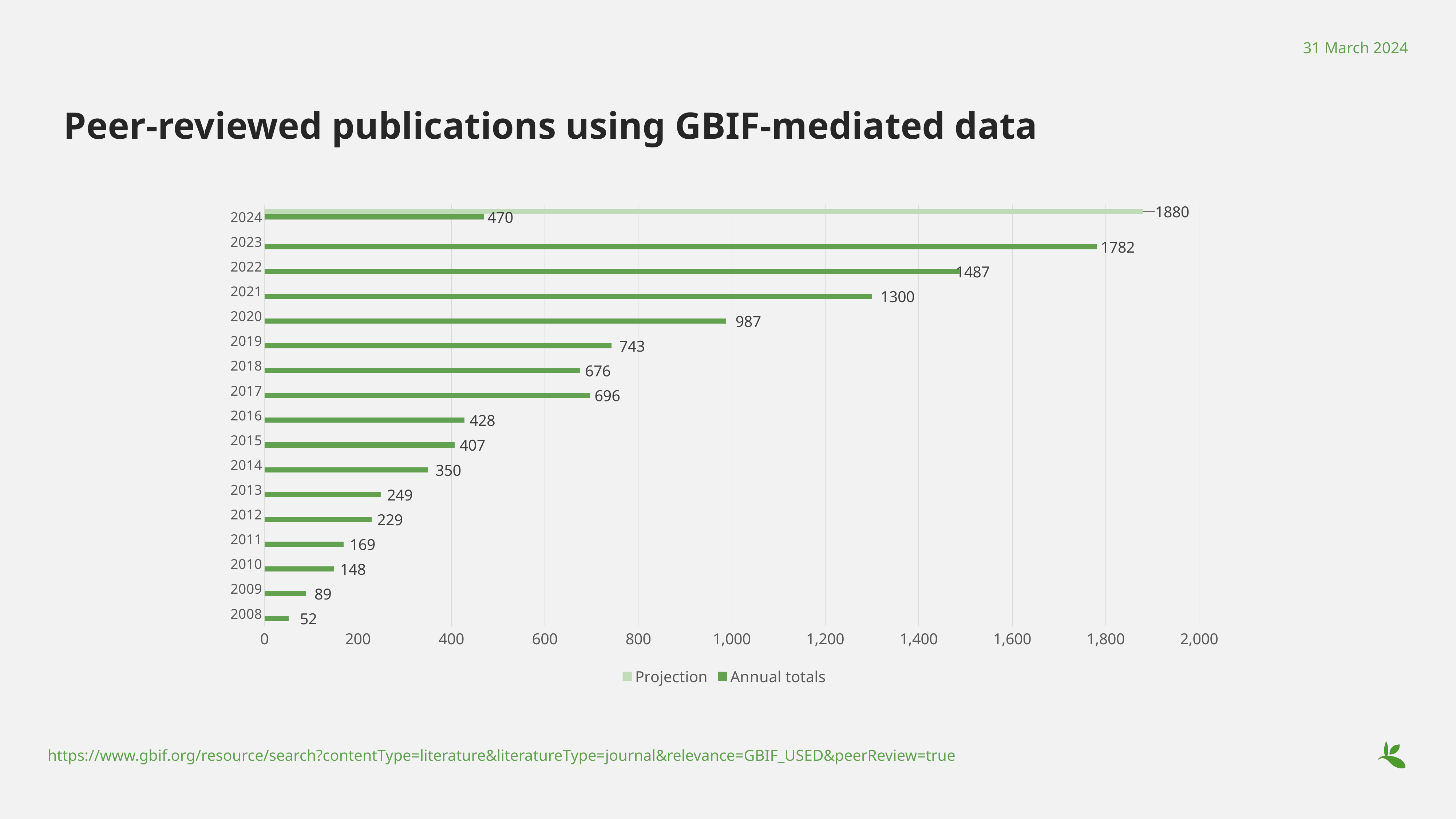
What kind of chart is shown? bar chart What is the annual total for 2023? 1782 What is the annual total for 2008? 52 Which year has the highest annual total? 2023 Which year has the lowest annual total? 2008 How many series does the legend list? 2 Is the annual total for 2020 greater or less than 1,000? less What is the projection value for 2024? 1880 Which is larger, the annual total for 2017 or for 2018? 2017 What is the difference between the annual totals for 2023 and 2022? 295 How many years are shown on the chart? 17 What is the title of the chart? Peer-reviewed publications using GBIF-mediated data